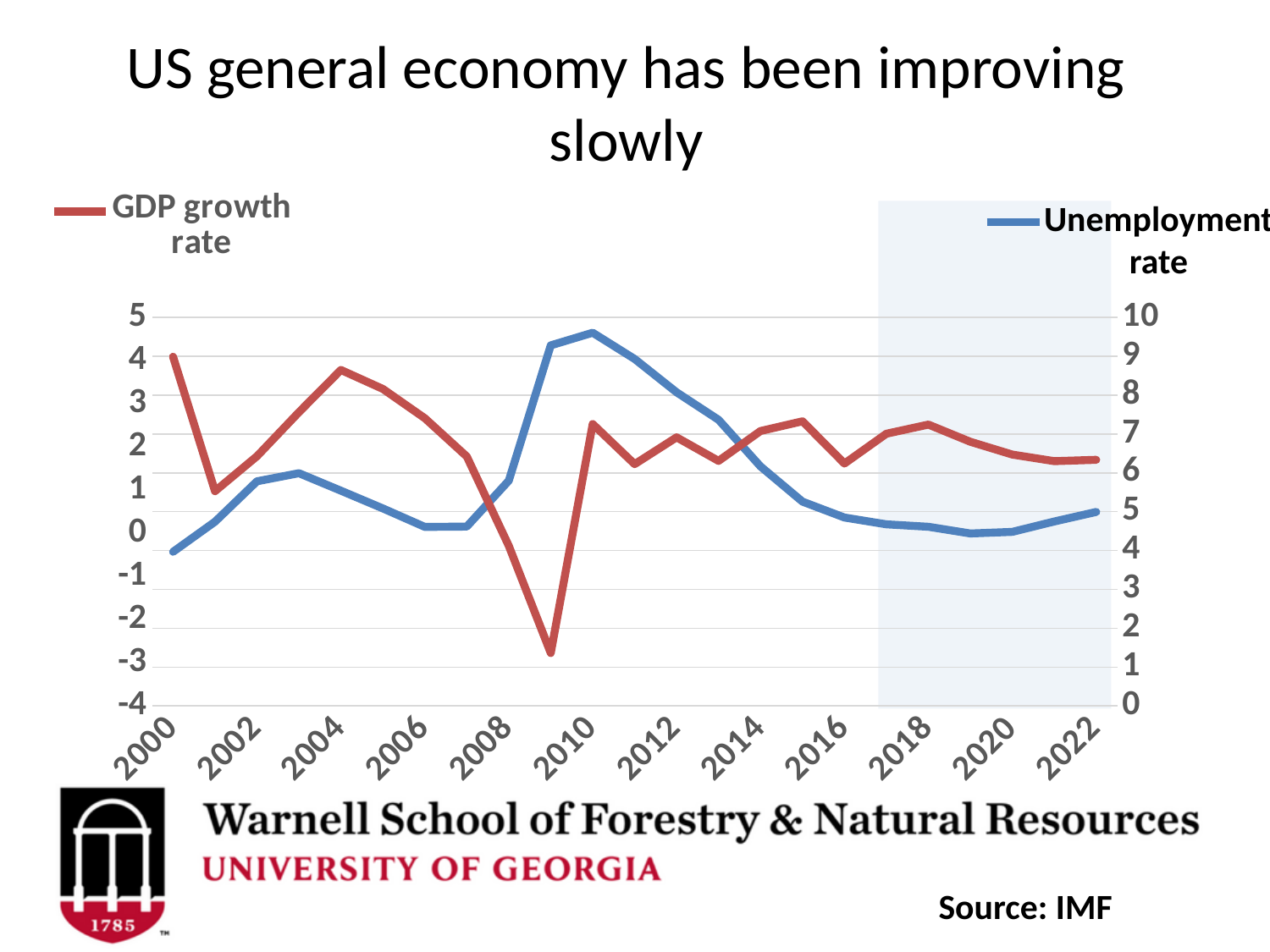
Is the unemployment rate in 2000 greater or less than 5? less In which year does the GDP growth rate reach its highest point? 2000 What source is cited for the chart data? IMF Is the unemployment rate in 2010 greater or less than 9? greater How many series does the chart plot? 2 What kind of chart is shown on the slide? line chart Does the unemployment rate rise or fall between 2010 and 2019? fall Which series is drawn in red? GDP growth rate Does the GDP growth rate rise or fall between 2004 and 2009? fall In which year does the GDP growth rate reach its lowest point? 2009 Is the GDP growth rate in 2009 greater or less than -2? less